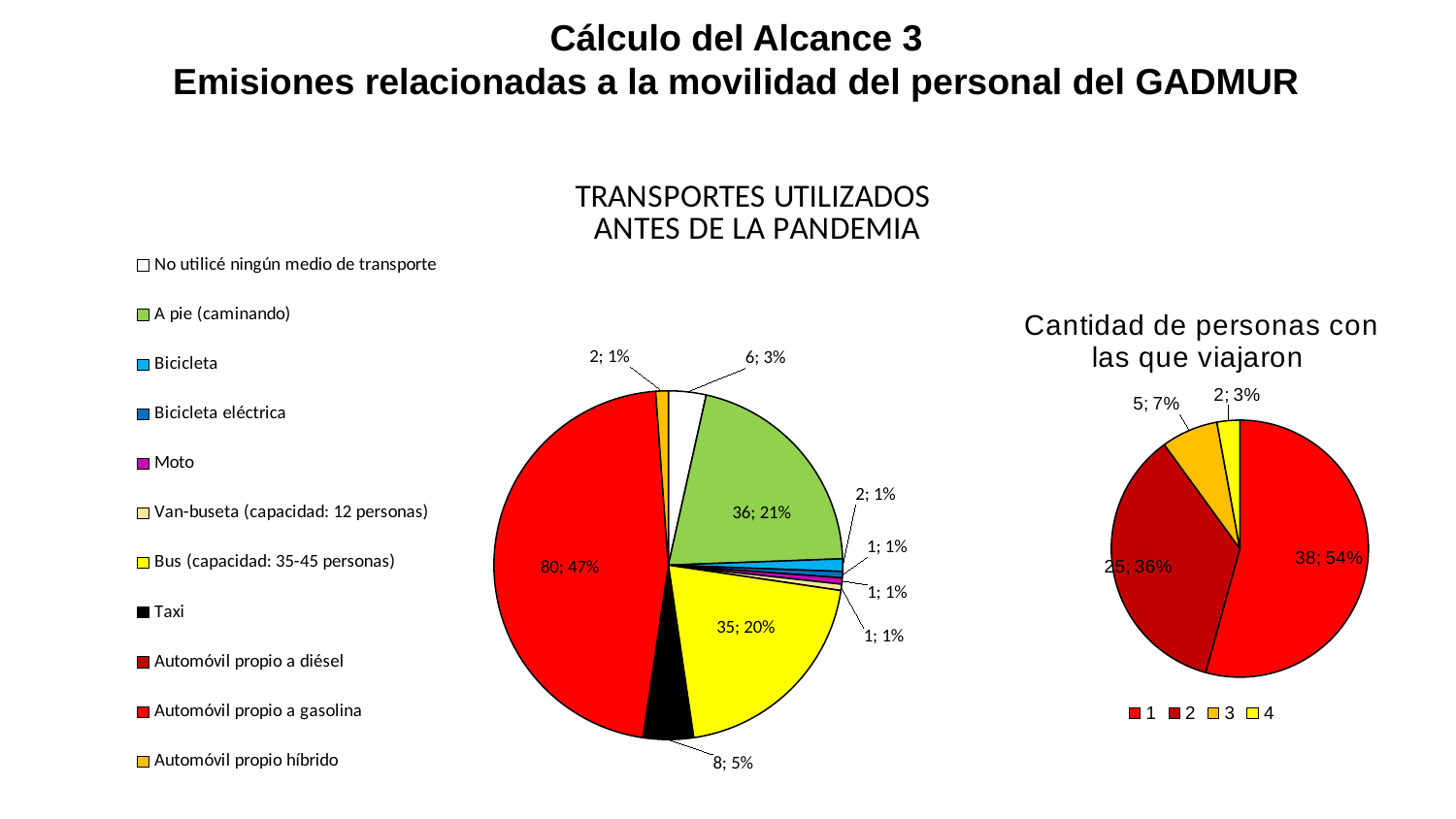
In the chart 'TRANSPORTES UTILIZADOS ANTES DE LA PANDEMIA', what value and percentage are shown for 'A pie (caminando)'? 36; 21% In the chart 'TRANSPORTES UTILIZADOS ANTES DE LA PANDEMIA', how many categories does the legend list? 11 In the chart 'Cantidad de personas con las que viajaron', what value and percentage are shown for category 2? 25; 36% In the chart 'TRANSPORTES UTILIZADOS ANTES DE LA PANDEMIA', what is the difference between the values for 'A pie (caminando)' and 'Bus (capacidad: 35-45 personas)'? 1 In the chart 'Cantidad de personas con las que viajaron', what is the difference between the values for category 1 and category 2? 13 In the chart 'Cantidad de personas con las que viajaron', which category has the smallest slice? 4 In the chart 'TRANSPORTES UTILIZADOS ANTES DE LA PANDEMIA', which category has the largest slice? Automóvil propio a gasolina In the chart 'TRANSPORTES UTILIZADOS ANTES DE LA PANDEMIA', what value and percentage are shown for 'Taxi'? 8; 5% What type of chart is 'Cantidad de personas con las que viajaron'? Pie chart In the chart 'TRANSPORTES UTILIZADOS ANTES DE LA PANDEMIA', what share of the pie does 'Automóvil propio a gasolina' represent? 47% In the chart 'TRANSPORTES UTILIZADOS ANTES DE LA PANDEMIA', what value and percentage are shown for 'Bus (capacidad: 35-45 personas)'? 35; 20% In the chart 'Cantidad de personas con las que viajaron', what value and percentage are shown for category 1? 38; 54%